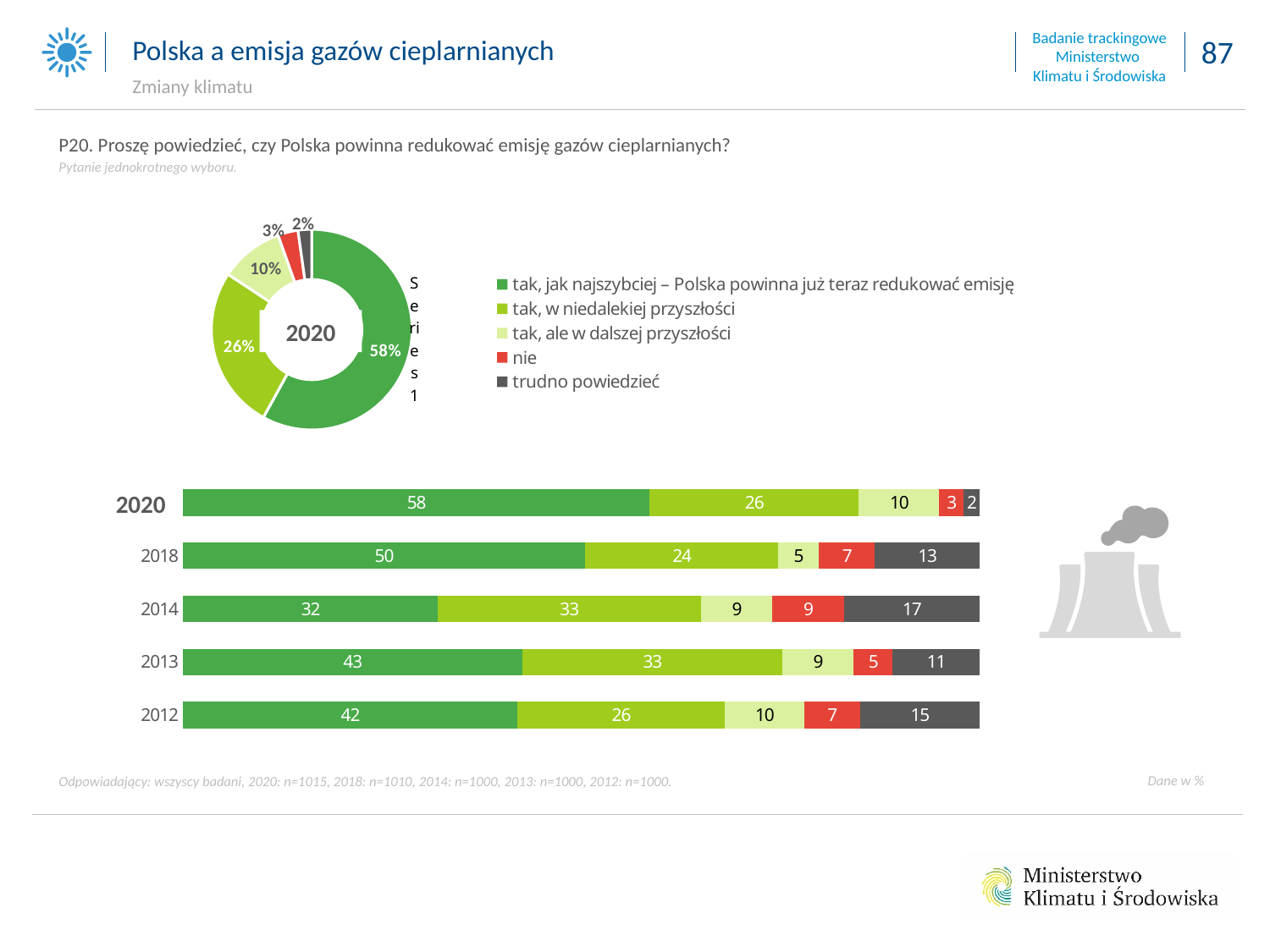
What kind of chart is the upper chart on the slide? Donut (pie) chart How many years are shown in the stacked bar chart? 5 In the donut chart, which response has the smallest share? trudno powiedzieć In the stacked bar chart, what is the value for "tak, jak najszybciej" in 2018? 50 In the stacked bar chart, is the "nie" value larger in 2014 or in 2013? 2014 In the stacked bar chart, what is the difference between the "tak, jak najszybciej" values for 2020 and 2018? 8 In the stacked bar chart, what is the value for "trudno powiedzieć" in 2014? 17 How many entries does the legend of the donut chart list? 5 In the donut chart, what share of respondents in 2020 answered "nie"? 3% In the stacked bar chart, which year has the lowest value for "tak, jak najszybciej"? 2014 In the stacked bar chart, which year has the highest value for "tak, jak najszybciej"? 2020 In the donut chart, what share of respondents in 2020 chose "tak, jak najszybciej – Polska powinna już teraz redukować emisję"? 58%